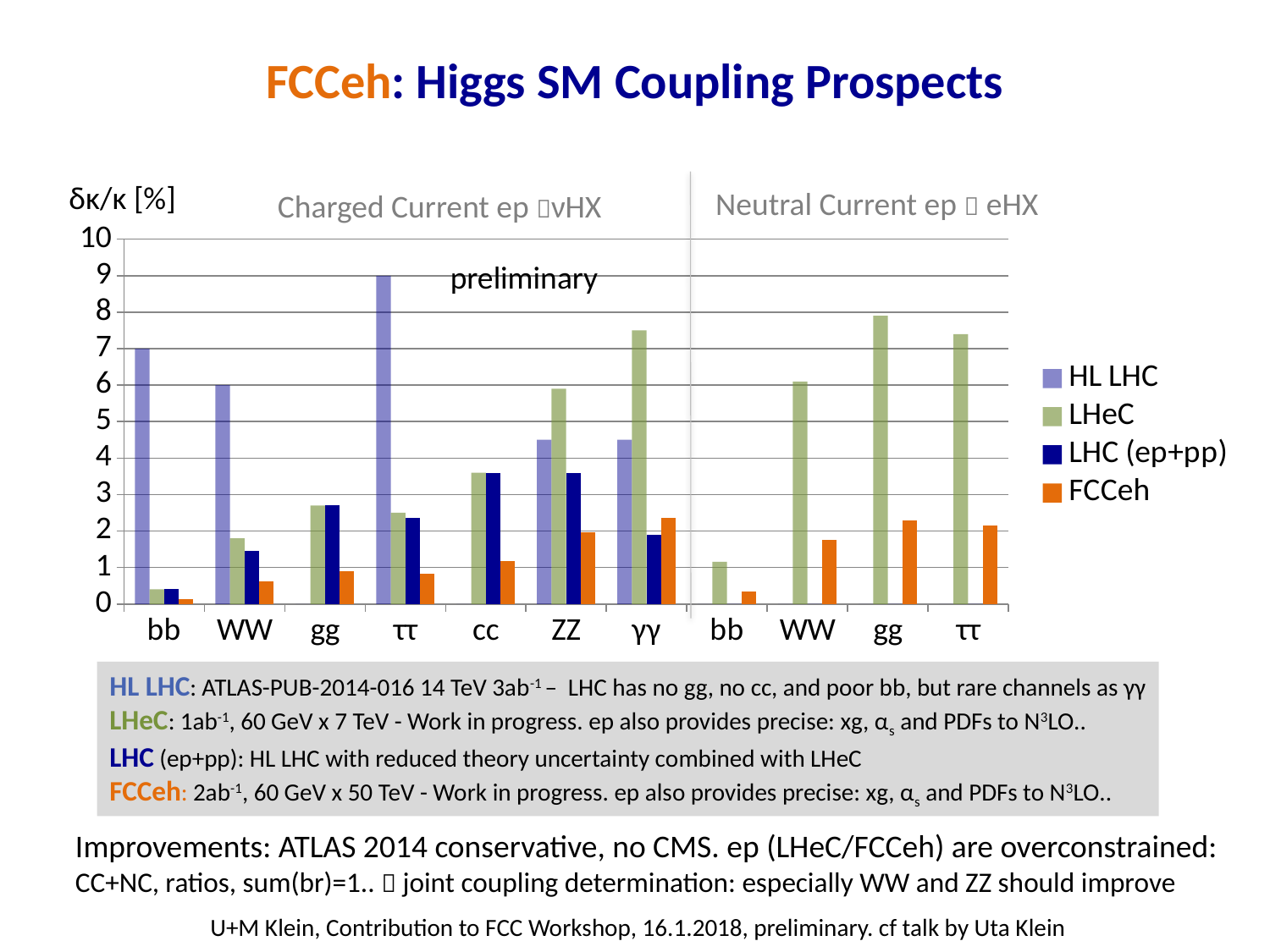
What kind of chart is shown on the slide? bar chart What is the HL LHC value for ττ in the Charged Current section? 9 For bb in the Charged Current section, which is larger: HL LHC or LHeC? HL LHC What is the label on the y axis? δκ/κ [%] Is the LHeC value for gg in the Neutral Current section greater or less than 7? greater Is the LHeC value for bb in the Charged Current section greater or less than 1? less Is the LHeC value for ZZ greater or less than 5? greater For which category is the HL LHC value highest? ττ How many series does the legend list? 4 What is the HL LHC value for bb in the Charged Current section? 7 How many categories are shown along the x axis? 11